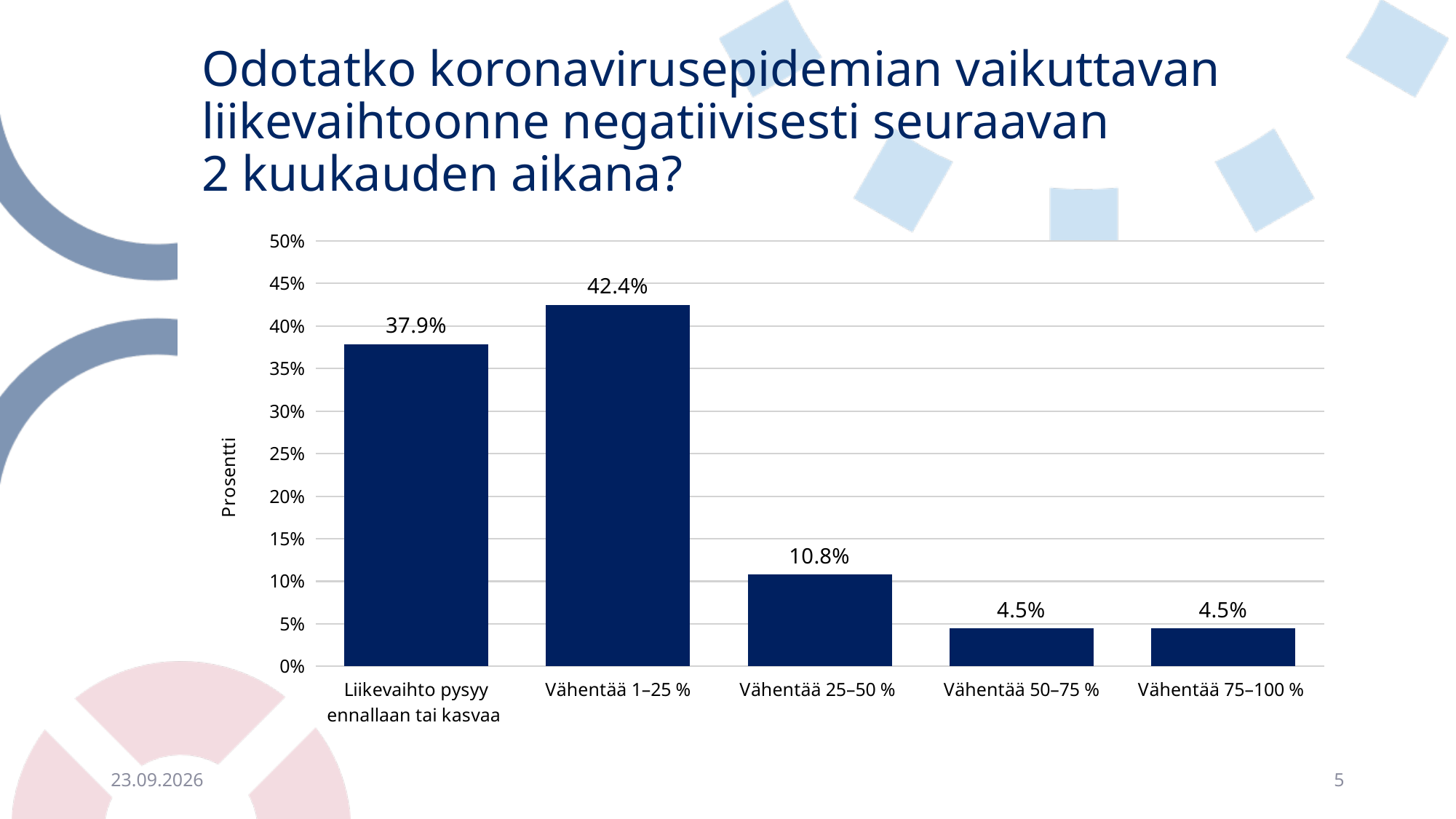
What is the value for "Vähentää 50–75 %"? 4.5% Which category has the highest value? Vähentää 1–25 % What is the value for "Liikevaihto pysyy ennallaan tai kasvaa"? 37.9% What is the difference between the values for "Vähentää 1–25 %" and "Liikevaihto pysyy ennallaan tai kasvaa"? 4.5% What kind of chart is shown on the slide? bar chart How many categories are shown on the x axis? 5 What is the difference between the values for "Vähentää 25–50 %" and "Vähentää 50–75 %"? 6.3% What is the label of the vertical axis? Prosentti What is the value for "Vähentää 25–50 %"? 10.8% Is the value for "Vähentää 1–25 %" greater or less than 40%? greater Which is larger, the value for "Liikevaihto pysyy ennallaan tai kasvaa" or the value for "Vähentää 25–50 %"? Liikevaihto pysyy ennallaan tai kasvaa What is the value for "Vähentää 1–25 %"? 42.4%